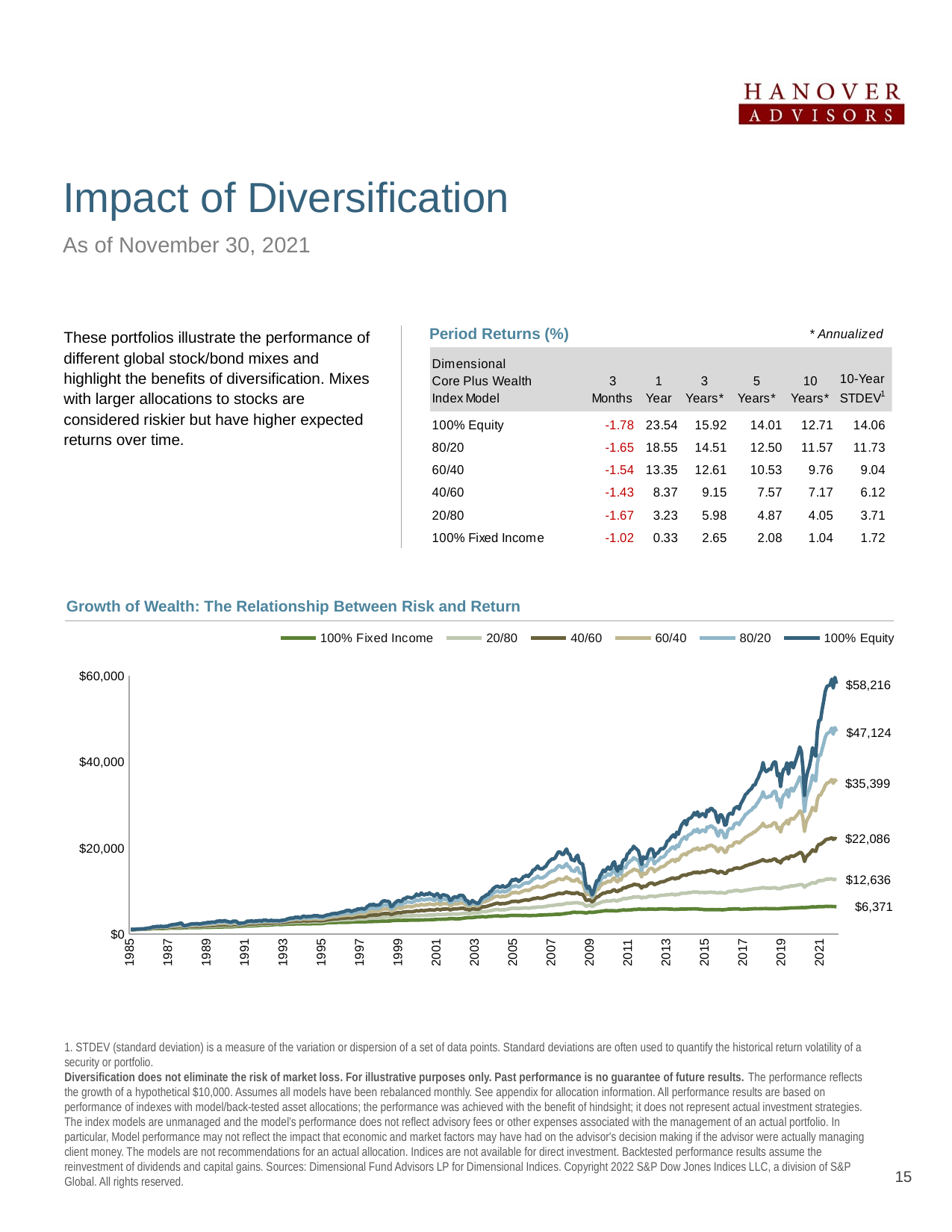
How many series does the legend of the Growth of Wealth chart list? 6 Which series ends with the lowest value in the Growth of Wealth chart? 100% Fixed Income What is the ending value labeled for the 100% Equity line in the Growth of Wealth chart? $58,216 In the Growth of Wealth chart, is the ending value of the 40/60 line greater or less than $20,000? greater What is the ending value labeled for the 20/80 line in the Growth of Wealth chart? $12,636 Over the x axis from 1985 to 2021, does the 100% Equity line in the Growth of Wealth chart generally rise or fall? Rise Which series ends with the highest value in the Growth of Wealth chart? 100% Equity In the Growth of Wealth chart, what is the difference between the ending values of the 80/20 line and the 40/60 line? $25,038 What type of chart is shown under "Growth of Wealth: The Relationship Between Risk and Return"? Line chart What is the ending value labeled for the 60/40 line in the Growth of Wealth chart? $35,399 In the Growth of Wealth chart, which ends higher: the 80/20 line or the 60/40 line? 80/20 What is the ending value labeled for the 100% Fixed Income line in the Growth of Wealth chart? $6,371